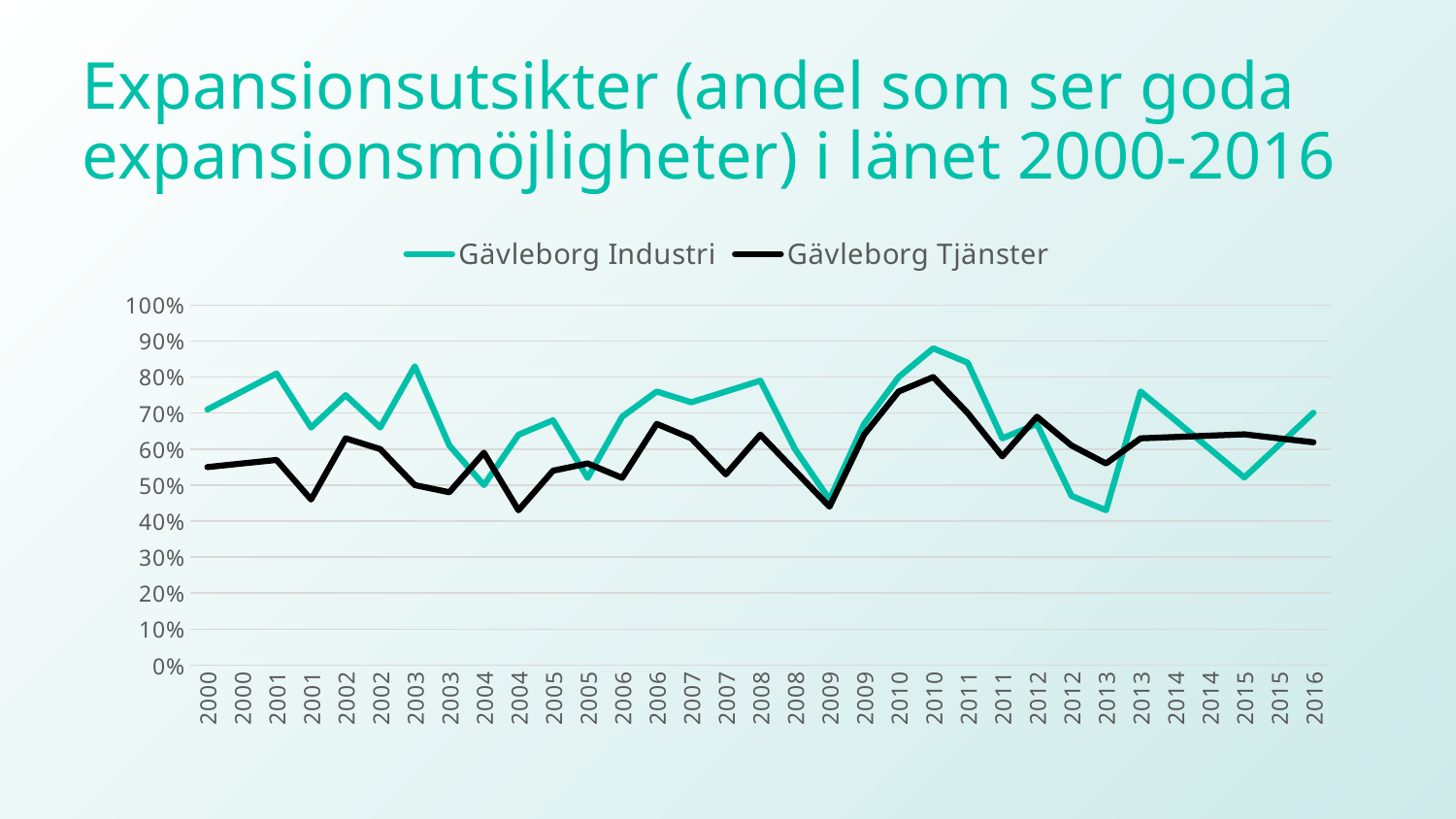
Is the peak value for Gävleborg Industri in 2010 greater or less than 80%? greater How many series does the legend list? 2 Is the value for Gävleborg Industri at the first 2000 point greater or less than 60%? greater At which year does the Gävleborg Tjänster line reach its highest value? 2010 Is the value for Gävleborg Tjänster at the first 2000 point greater or less than 60%? less At which year does the Gävleborg Industri line reach its highest value? 2010 Does the Gävleborg Industri line rise or fall between 2009 and 2010? rise At the second 2012 point, which series has the higher value, Gävleborg Industri or Gävleborg Tjänster? Gävleborg Tjänster Which series is drawn in black? Gävleborg Tjänster What are the two series named in the legend? Gävleborg Industri and Gävleborg Tjänster At the first 2000 point, which series has the higher value, Gävleborg Industri or Gävleborg Tjänster? Gävleborg Industri What kind of chart is shown on the slide? line chart